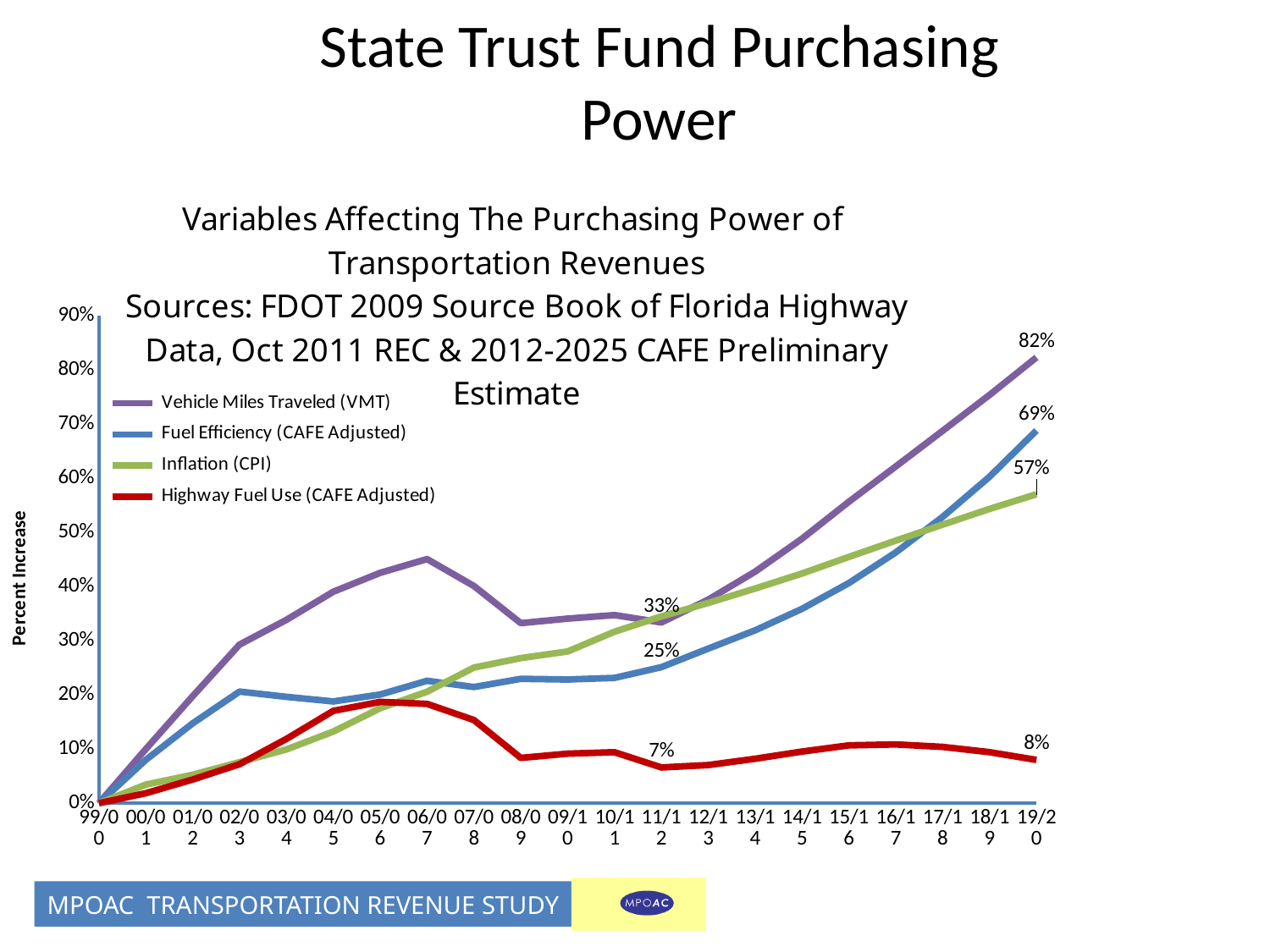
What type of chart is shown on the slide? Line chart What is the value for Highway Fuel Use (CAFE Adjusted) in 19/20? 8% What is the value for Highway Fuel Use (CAFE Adjusted) in 11/12? 7% What is the value for Inflation (CPI) in 19/20? 57% What is the value for Vehicle Miles Traveled (VMT) in 19/20? 82% What is the value for Fuel Efficiency (CAFE Adjusted) in 19/20? 69% Which series has the highest value in 19/20? Vehicle Miles Traveled (VMT) What is the difference between the Vehicle Miles Traveled (VMT) and Fuel Efficiency (CAFE Adjusted) values in 19/20? 13 percentage points What is the label on the vertical axis? Percent Increase How many series does the legend list? 4 Which series has the lowest value in 19/20? Highway Fuel Use (CAFE Adjusted) Is the value for Vehicle Miles Traveled (VMT) in 06/07 greater or less than 40%? greater